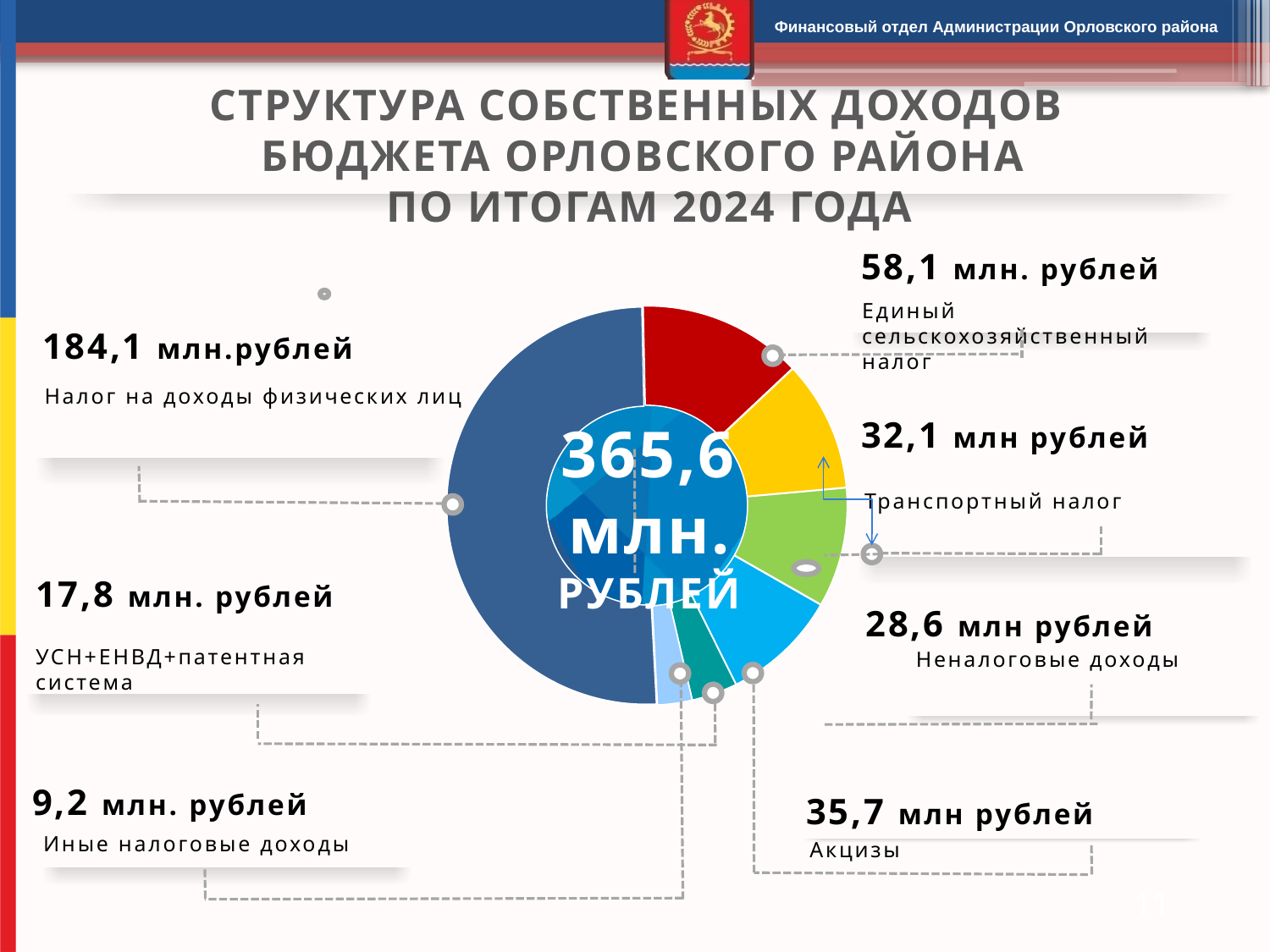
What is the value for Акцизы? 35,7 млн рублей How many categories are shown in the chart? 7 What is the value for Единый сельскохозяйственный налог? 58,1 млн. рублей What is the difference between Налог на доходы физических лиц and Единый сельскохозяйственный налог? 126,0 млн. рублей What is the value for Транспортный налог? 32,1 млн рублей What is the difference between УСН+ЕНВД+патентная система and Иные налоговые доходы? 8,6 млн. рублей What is the total value shown in the centre of the chart? 365,6 млн. рублей What is the value for Налог на доходы физических лиц? 184,1 млн.рублей What kind of chart is shown on the slide? Donut (pie) chart Which is larger: Акцизы or Неналоговые доходы? Акцизы Which category has the smallest value? Иные налоговые доходы Which category has the largest value? Налог на доходы физических лиц